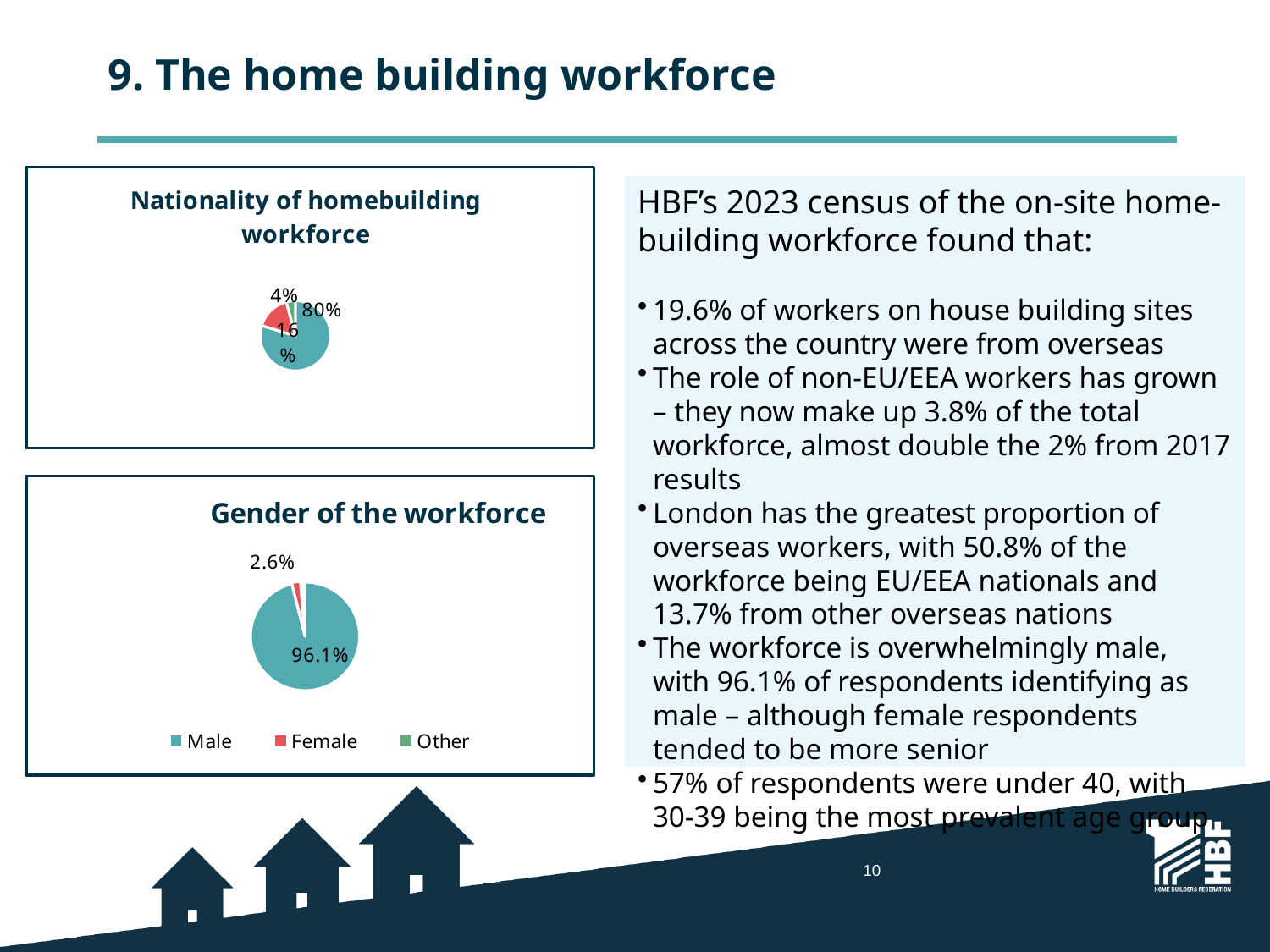
How many categories does the legend of the 'Gender of the workforce' chart list? 3 In the 'Gender of the workforce' chart, what percentage of the workforce is Female? 2.6% In the 'Gender of the workforce' chart, which is larger, the Male share or the Female share? Male In the 'Gender of the workforce' chart, which category has the largest share? Male In the 'Gender of the workforce' chart, what is the difference in percentage points between the Male and Female shares? 93.5 What kind of chart is the 'Nationality of homebuilding workforce' chart? Pie chart What kind of chart is the 'Gender of the workforce' chart? Pie chart In the 'Nationality of homebuilding workforce' chart, what is the value of the largest slice? 80% What is the title of the top chart on the slide? Nationality of homebuilding workforce How many slices does the 'Nationality of homebuilding workforce' pie chart have? 3 In the 'Gender of the workforce' chart, what percentage of the workforce is Male? 96.1% In the 'Nationality of homebuilding workforce' chart, what is the value of the smallest slice? 4%